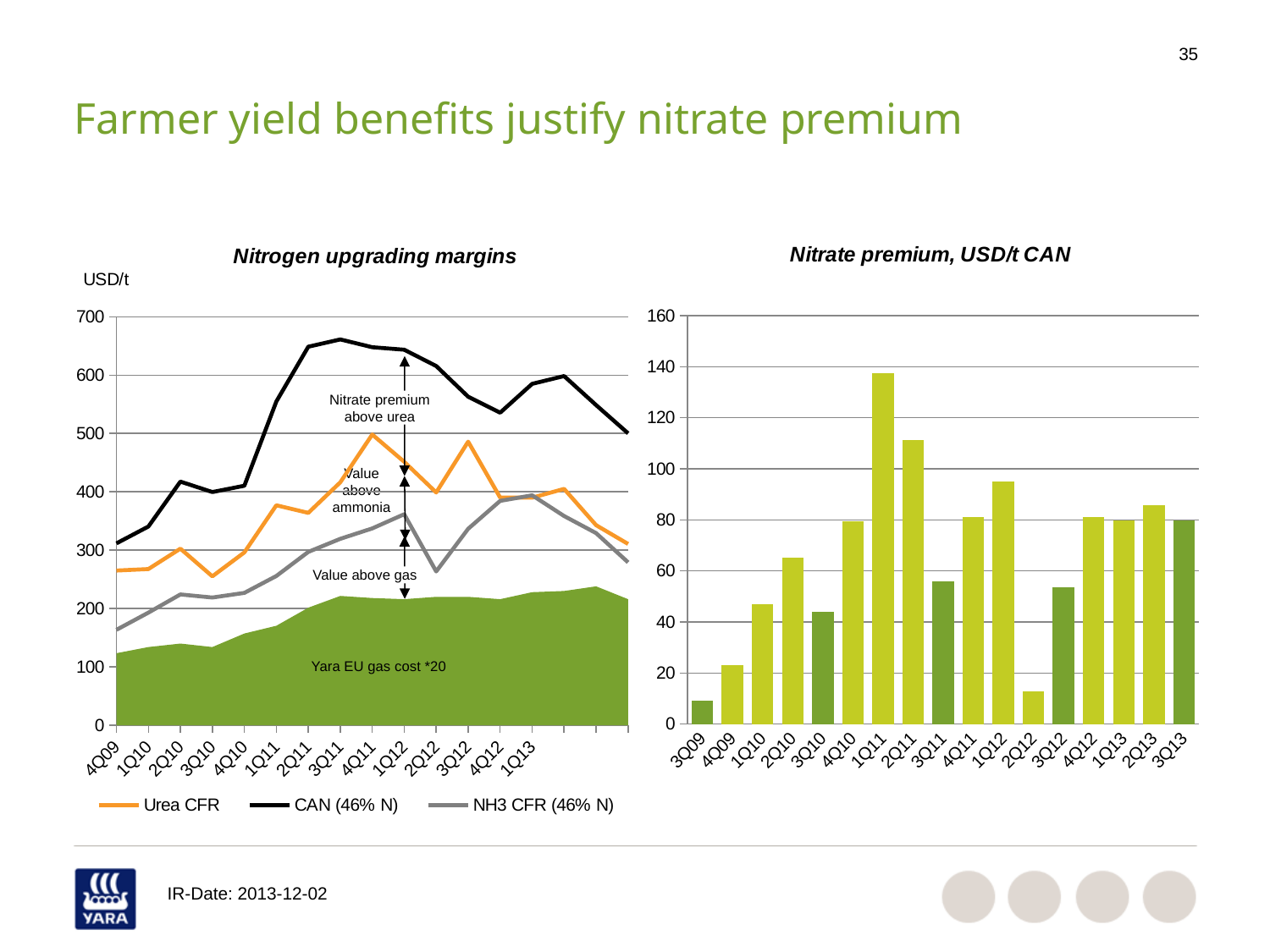
What kind of chart is the 'Nitrate premium, USD/t CAN' chart on the right? bar chart In the 'Nitrate premium, USD/t CAN' chart, which quarter has the lowest bar? 3Q09 In the 'Nitrate premium, USD/t CAN' chart, which is larger, the value for 2Q12 or the value for 3Q12? 3Q12 In the 'Nitrate premium, USD/t CAN' chart, is the value for 1Q11 greater or less than 120? greater What unit is shown on the y axis of the 'Nitrogen upgrading margins' chart? USD/t In the 'Nitrate premium, USD/t CAN' chart, is the value for 2Q10 greater or less than 60? greater How many quarters are shown on the x axis of the 'Nitrate premium, USD/t CAN' chart? 17 In the 'Nitrate premium, USD/t CAN' chart, is the value for 2Q12 greater or less than 20? less In the 'Nitrate premium, USD/t CAN' chart, which is larger, the value for 1Q11 or the value for 2Q11? 1Q11 In the 'Nitrate premium, USD/t CAN' chart, which quarter has the highest bar? 1Q11 How many series does the legend of the 'Nitrogen upgrading margins' chart list? 3